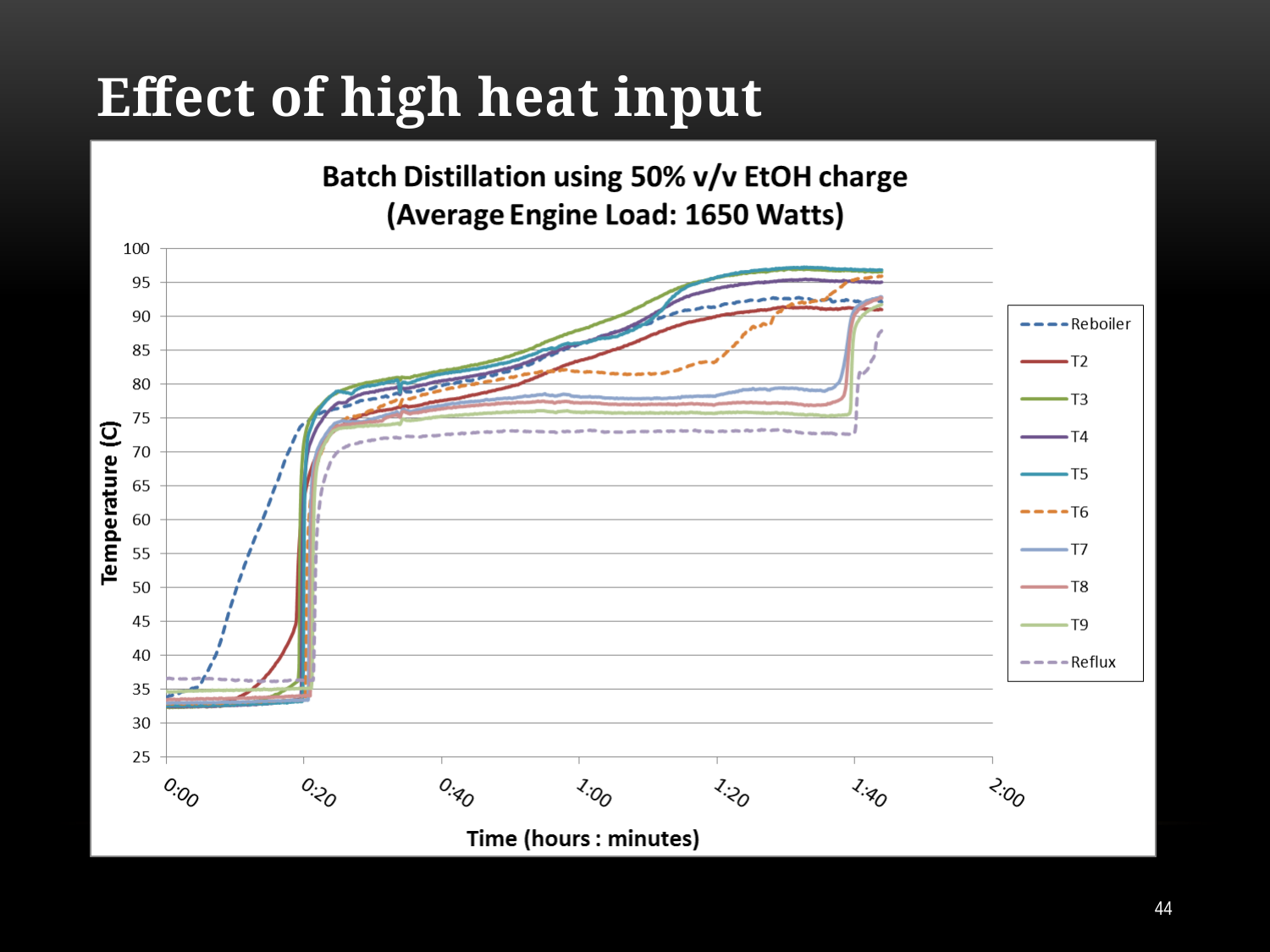
How many series does the legend list? 10 Is the T6 value at 1:10 greater or less than 85? less At 1:00, which is higher, the Reboiler or the Reflux temperature? Reboiler Is the Reflux value at 1:00 greater or less than 75? less Is the T3 value at 1:20 greater or less than 90? greater What is the label of the vertical axis? Temperature (C) Which series has the lowest temperature at 1:00? Reflux Does the T3 temperature generally rise or fall from 0:00 to 1:40? rise What kind of chart is shown on the slide? line chart What is the title of the chart? Batch Distillation using 50% v/v EtOH charge (Average Engine Load: 1650 Watts)